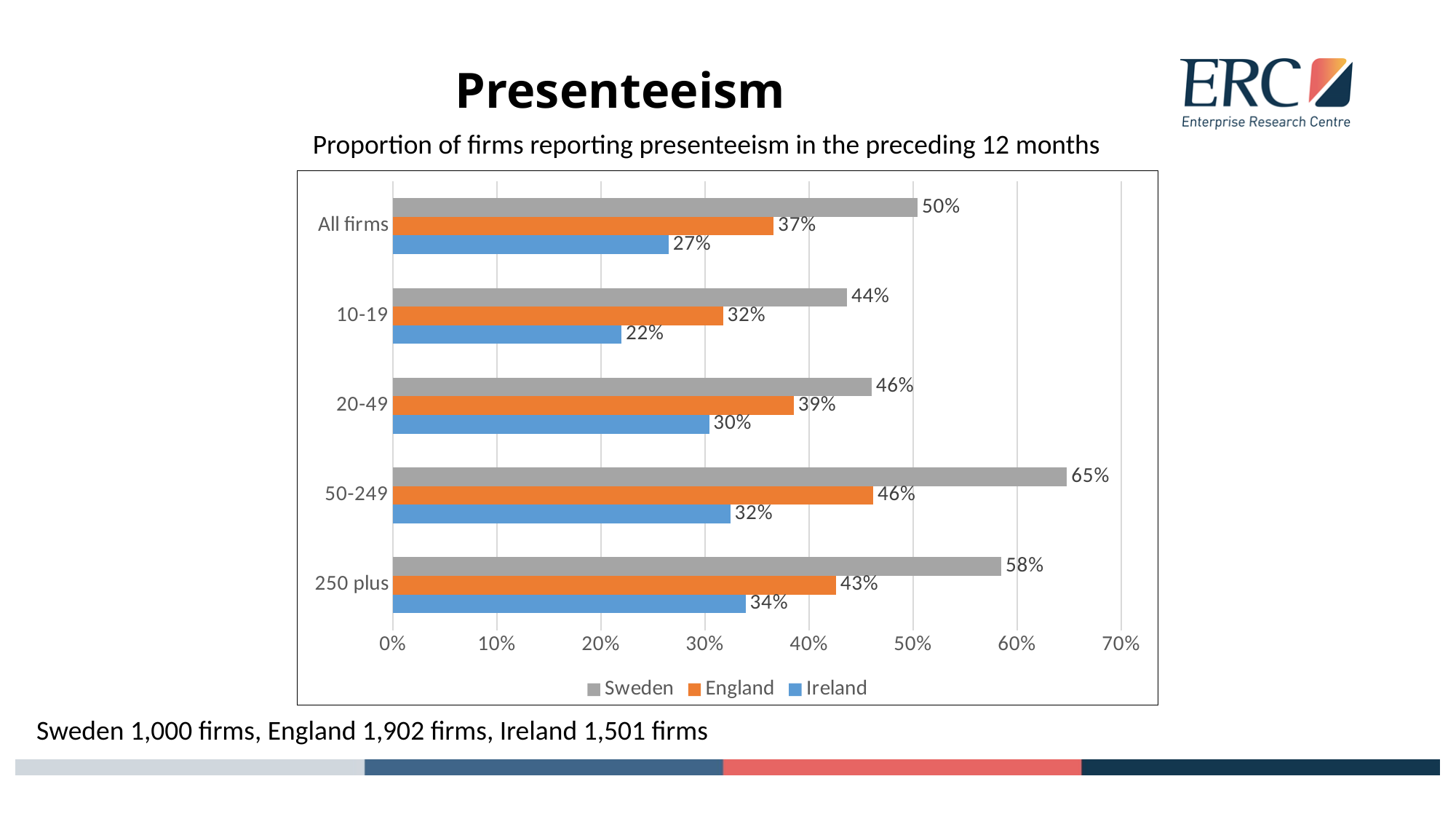
How many firm size categories are shown on the chart? 5 Which firm size category has the lowest value for Ireland? 10-19 Which firm size category has the highest value for Sweden? 50-249 Which colour represents England in the chart? Orange What is the difference between the Sweden and Ireland values in the 250 plus category? 24% Is the value for Sweden in the 50-249 category greater or less than 60%? greater Which is larger in the 20-49 category: the value for England or the value for Ireland? England What kind of chart is shown on the slide? Bar chart What is the value for England for All firms? 37% What is the value for Sweden in the 50-249 category? 65% How many series does the legend list? 3 What is the value for Ireland in the 10-19 category? 22%